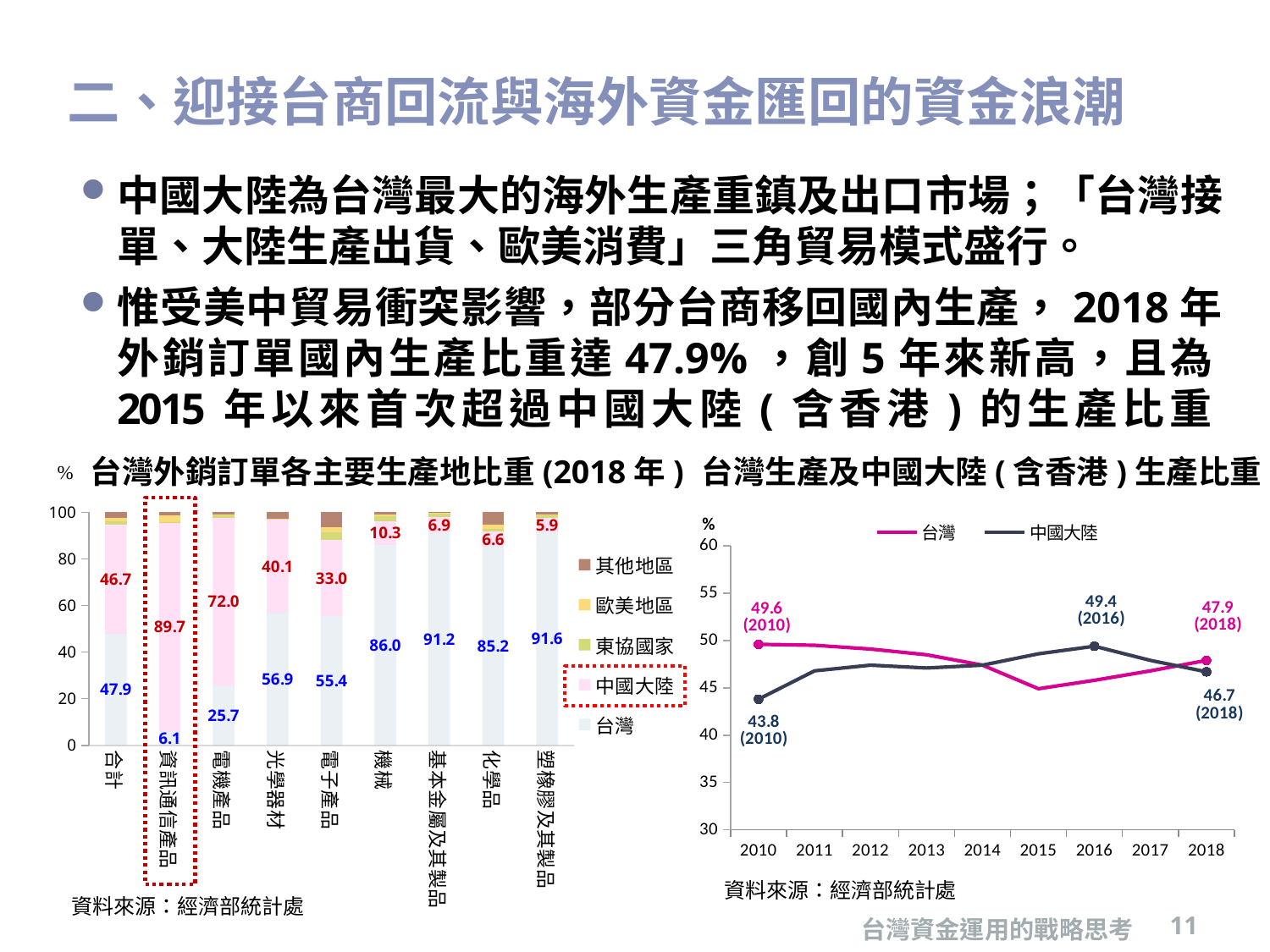
How many series does the legend of the left chart (台灣外銷訂單各主要生產地比重) list? 5 In the left chart (台灣外銷訂單各主要生產地比重), which category has the highest 中國大陸 share? 資訊通信產品 In the right chart (台灣生產及中國大陸(含香港)生產比重), what is the 台灣 value in 2018? 47.9 In the left chart (台灣外銷訂單各主要生產地比重), what is the difference between the 台灣 share and the 中國大陸 share for 合計? 1.2 In the right chart (台灣生產及中國大陸(含香港)生產比重), is the 中國大陸 value in 2015 greater or less than 45? greater In the right chart (台灣生產及中國大陸(含香港)生產比重), which series has the larger value in 2010, 台灣 or 中國大陸? 台灣 What kind of chart is the left chart (台灣外銷訂單各主要生產地比重)? Stacked bar chart In the left chart (台灣外銷訂單各主要生產地比重), what is the 台灣 share for 機械? 86.0 In the left chart (台灣外銷訂單各主要生產地比重), which category has the lowest 台灣 share? 資訊通信產品 In the right chart (台灣生產及中國大陸(含香港)生產比重), what is the 中國大陸 value in 2016? 49.4 How many product categories are shown on the x axis of the left chart (台灣外銷訂單各主要生產地比重)? 9 In the left chart (台灣外銷訂單各主要生產地比重), what is the 中國大陸 share for 資訊通信產品? 89.7